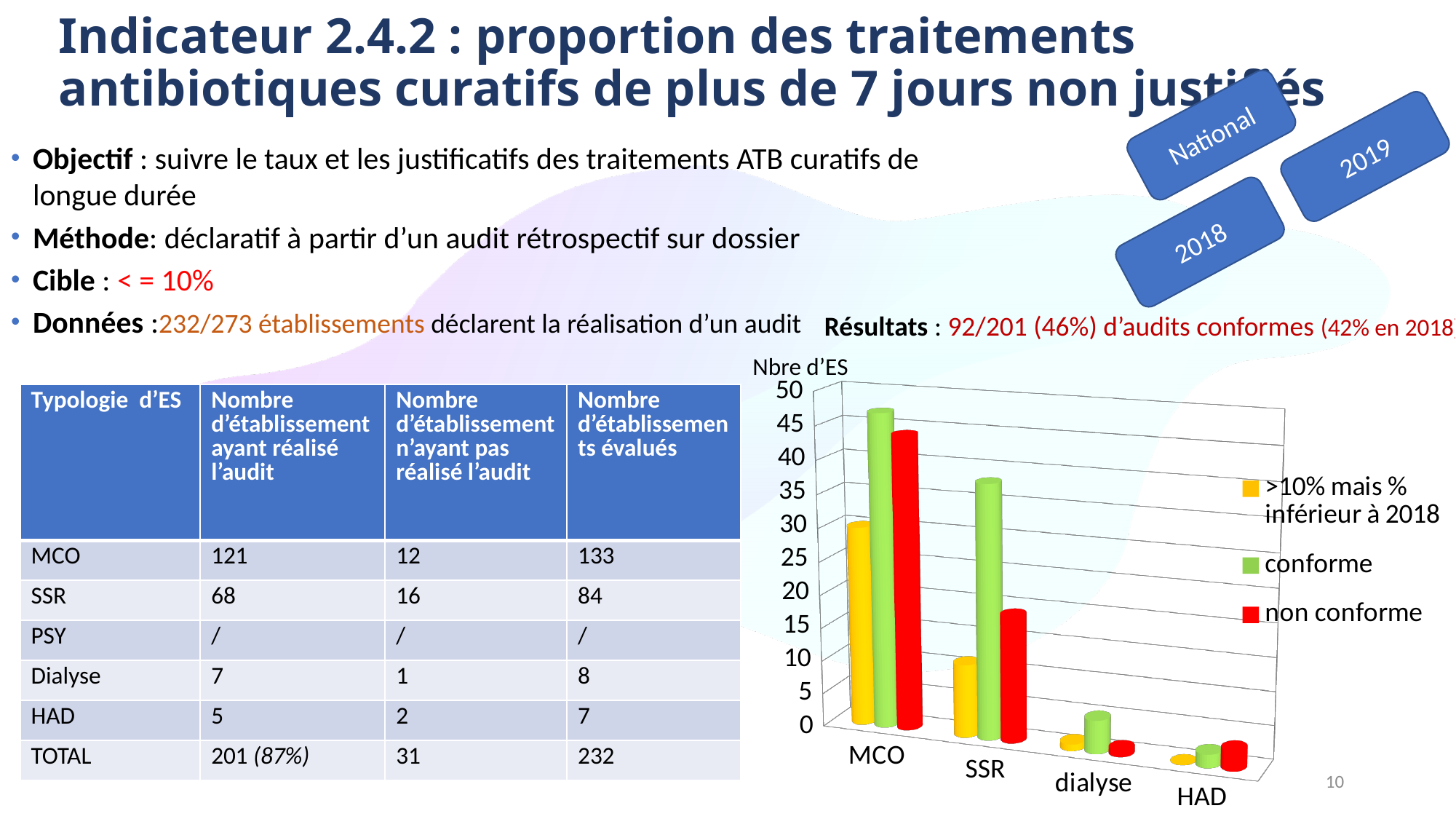
Do the 'conforme' values rise or fall from MCO to HAD along the x axis? fall Is the 'conforme' value for SSR greater or less than 30? greater Is the 'conforme' value for MCO greater or less than 40? greater How many series does the chart legend list? 3 What kind of chart is shown on the slide? bar chart Which is larger: the 'non conforme' value for MCO or the 'non conforme' value for SSR? MCO Is the '>10% mais % inférieur à 2018' value for MCO greater or less than 25? greater What label is shown on the vertical axis of the chart? Nbre d'ES How many categories are shown on the x axis of the chart? 4 Which category has the highest value for the 'conforme' series? MCO For SSR, which series has the highest bar? conforme